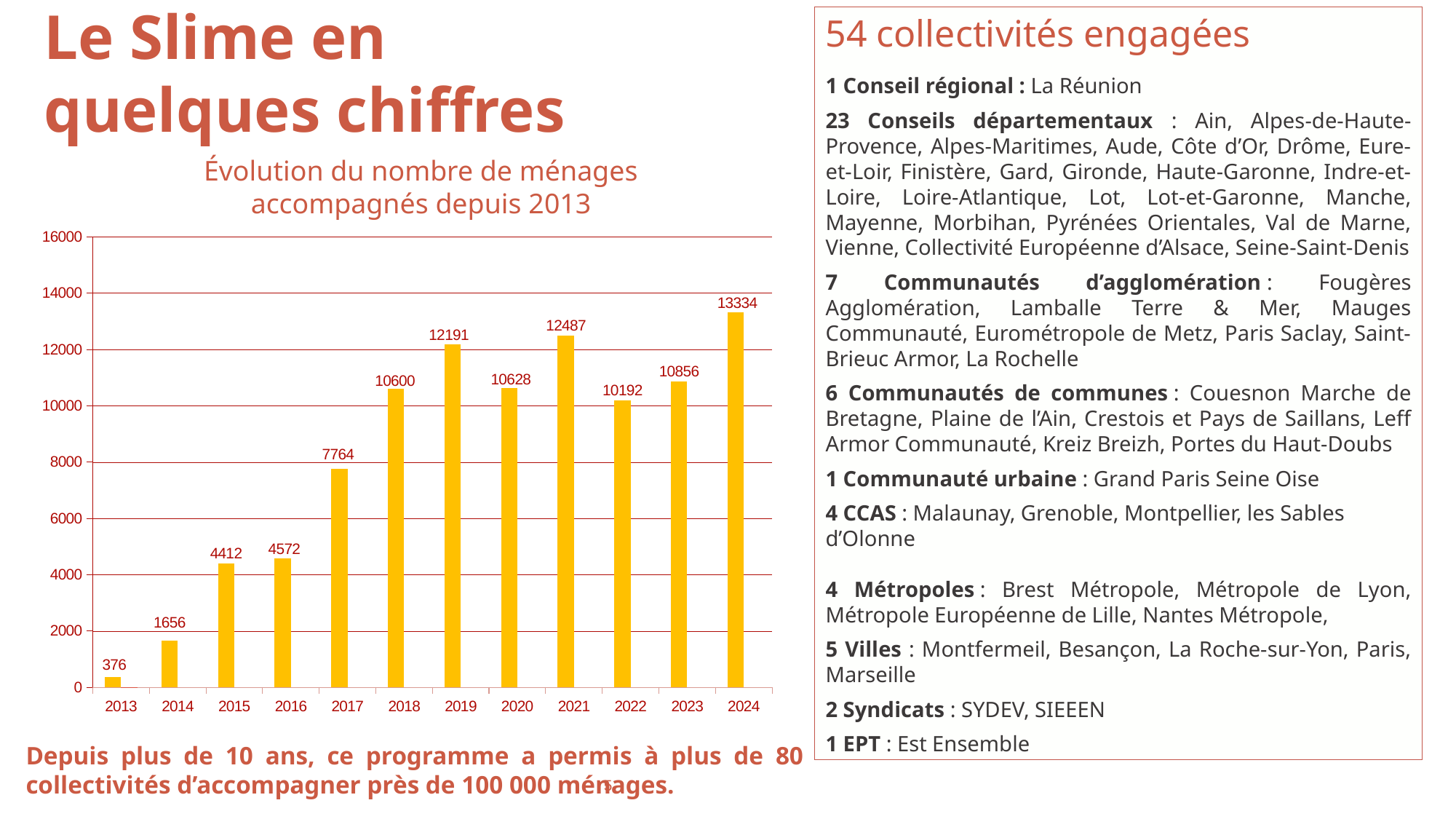
What kind of chart is this? bar chart What is the difference between the values for 2024 and 2023? 2478 What is the value for 2017? 7764 Which year has the highest value? 2024 Which is larger, the value for 2019 or the value for 2020? 2019 Which year has the lowest value? 2013 How many years are shown on the x axis? 12 What is the title of the chart? Évolution du nombre de ménages accompagnés depuis 2013 What is the value for 2013? 376 Is the value for 2018 greater or less than 10000? greater What is the value for 2021? 12487 What is the difference between the values for 2016 and 2015? 160